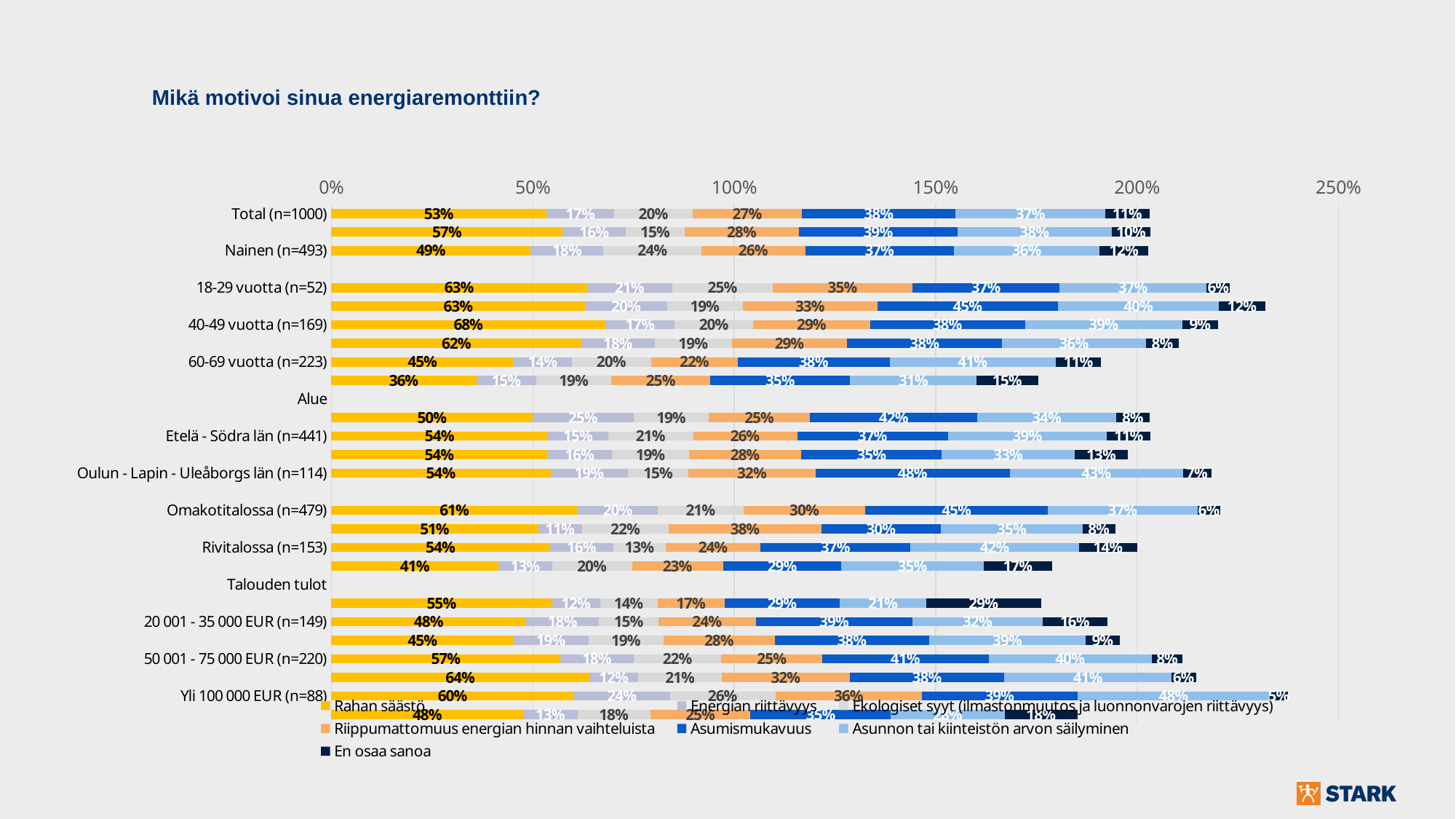
How many series does the legend list? 7 Among the labelled groups, which has the highest value for Rahan säästö? 40-49 vuotta (n=169) What is the value of Riippumattomuus energian hinnan vaihteluista for 18-29 vuotta (n=52)? 35% What is the value of Ekologiset syyt for Yli 100 000 EUR (n=88)? 26% What is the title of the chart? Mikä motivoi sinua energiaremonttiin? Which is larger: the Asunnon tai kiinteistön arvon säilyminen value for 60-69 vuotta (n=223) or for Total (n=1000)? 60-69 vuotta (n=223) What is the value of Asumismukavuus for Oulun - Lapin - Uleåborgs län (n=114)? 48% What is the value of Rahan säästö for Total (n=1000)? 53% What is the value of Energian riittävyys for 20 001 - 35 000 EUR (n=149)? 18% What is the difference between the Rahan säästö values for Omakotitalossa (n=479) and Rivitalossa (n=153)? 7% What is the value of En osaa sanoa for Nainen (n=493)? 12% What kind of chart is shown on the slide? Stacked bar chart